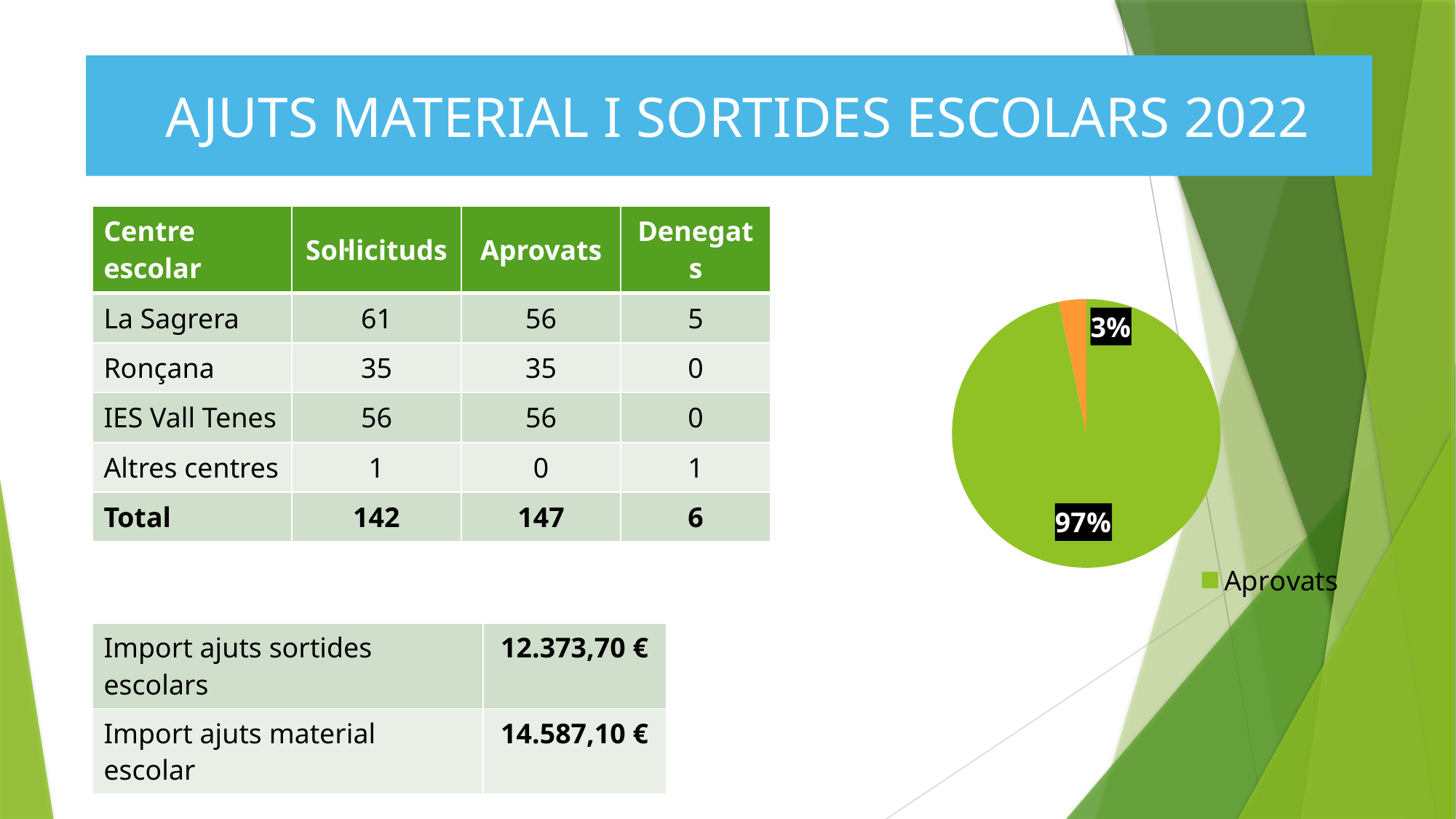
Is the Aprovats slice larger or smaller than the orange slice? larger Which slice of the pie chart is the largest? Aprovats What colour is the Aprovats slice in the pie chart? green Is the share of the Aprovats slice greater or less than 50%? greater How many slices does the pie chart have? 2 What share of the pie does the Aprovats slice represent? 97% What is the difference in percentage points between the 97% slice and the 3% slice? 94 percentage points Which entry is listed in the pie chart's legend? Aprovats What kind of chart is shown on the slide? pie chart What percentage is printed on the small orange slice of the pie chart? 3%